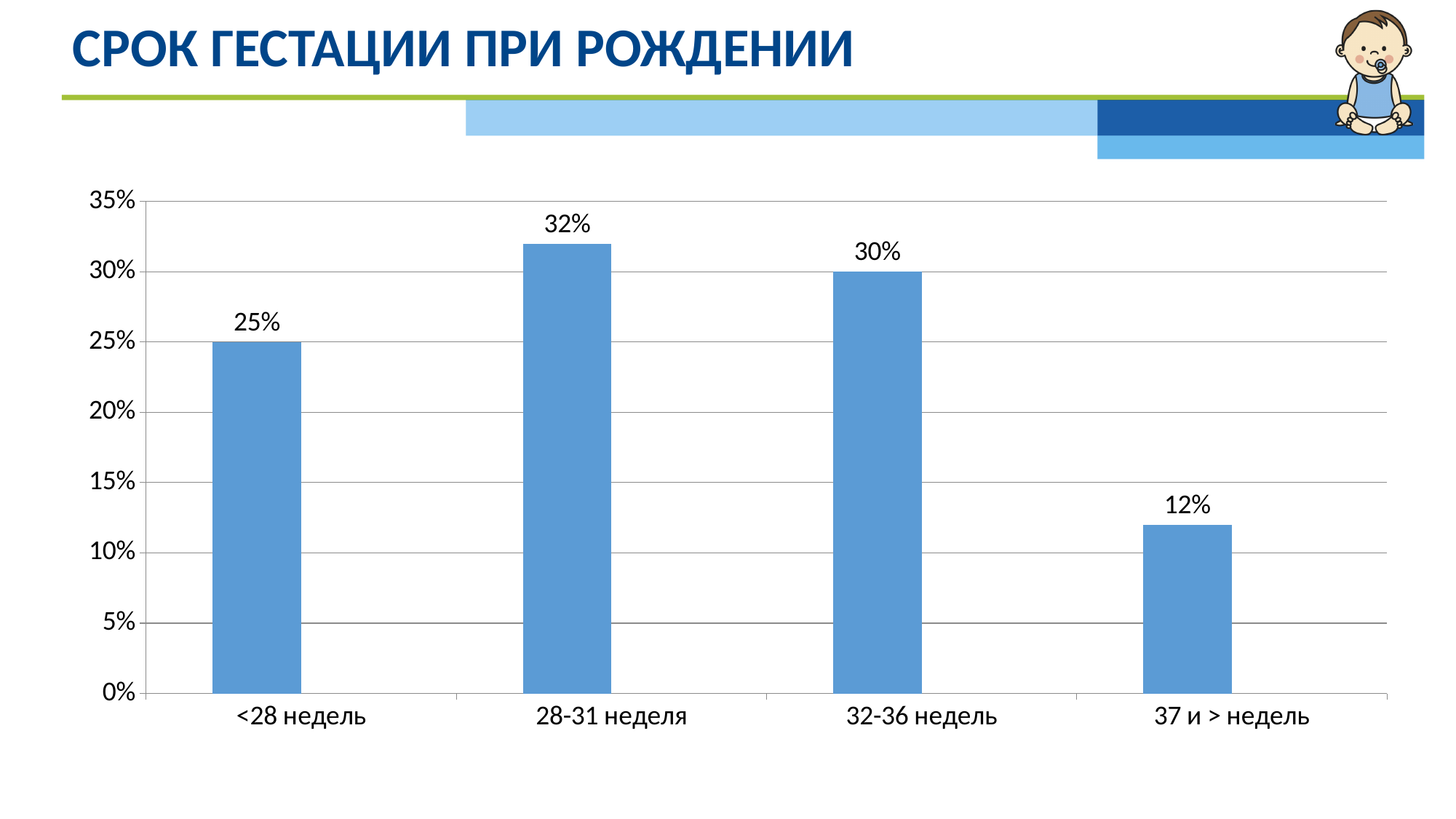
What is the difference between the values for 28-31 неделя and 37 и > недель? 20% What is the value for the 37 и > недель category? 12% Is the value for 37 и > недель greater or less than 15%? less What is the value for the 32-36 недель category? 30% Which category has the lowest value? 37 и > недель What kind of chart is shown on the slide? bar chart What is the value for the <28 недель category? 25% What is the difference between the values for 32-36 недель and <28 недель? 5% What is the value for the 28-31 неделя category? 32% Which category has the highest value? 28-31 неделя Which is larger, the value for <28 недель or the value for 32-36 недель? 32-36 недель How many categories are shown on the x axis? 4